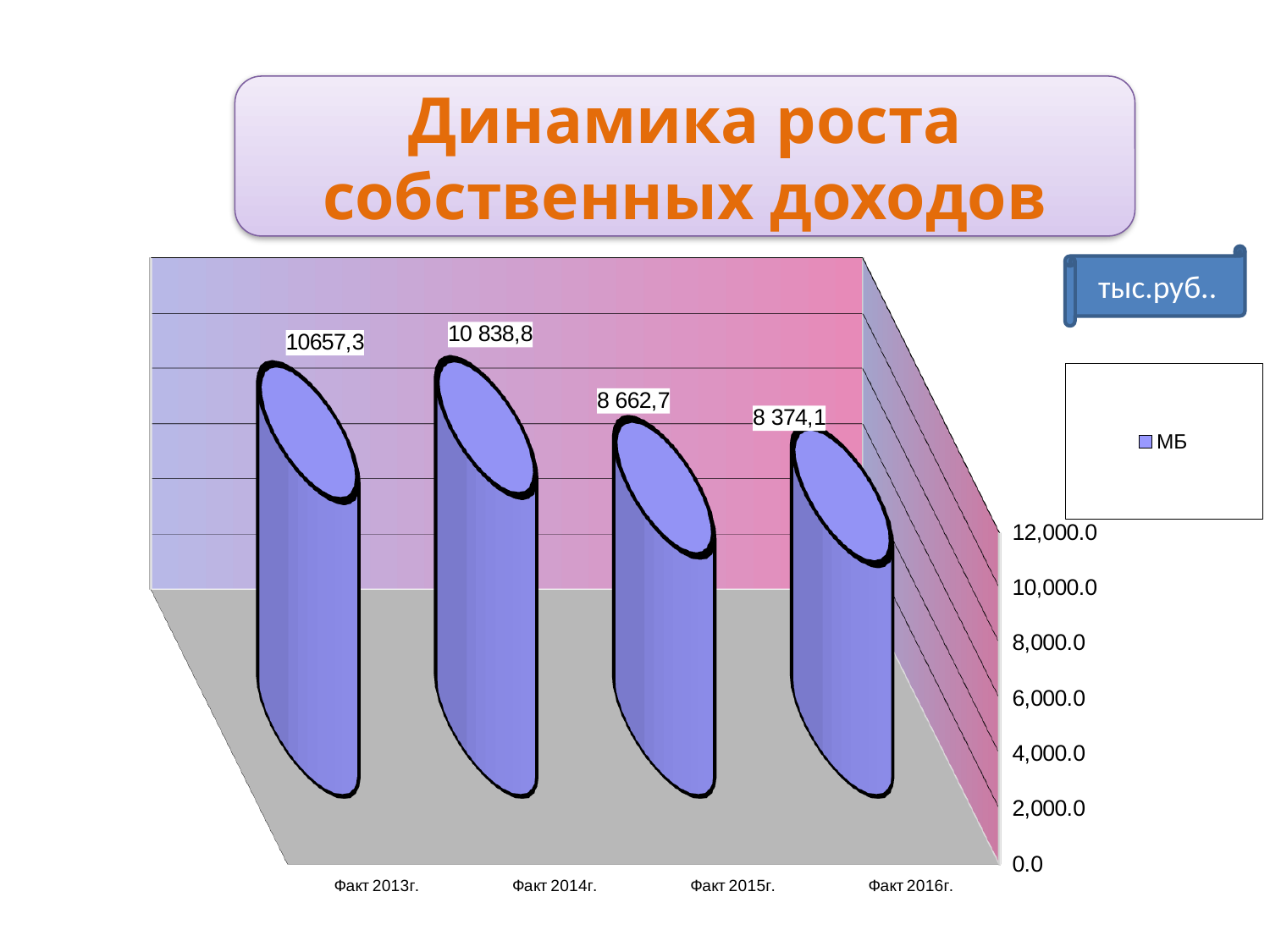
How many categories are shown on the x axis? 4 What is the value for Факт 2014г.? 10 838,8 What is the value for Факт 2016г.? 8 374,1 Which category has the highest value? Факт 2014г. What is the difference between the values for Факт 2015г. and Факт 2016г.? 288,6 What is the value for Факт 2013г.? 10657,3 Which is larger, the value for Факт 2013г. or the value for Факт 2015г.? Факт 2013г. What kind of chart is shown on the slide? Bar chart Which category has the lowest value? Факт 2016г. What is the value for Факт 2015г.? 8 662,7 What is the difference between the values for Факт 2014г. and Факт 2013г.? 181,5 What series name does the legend list? МБ